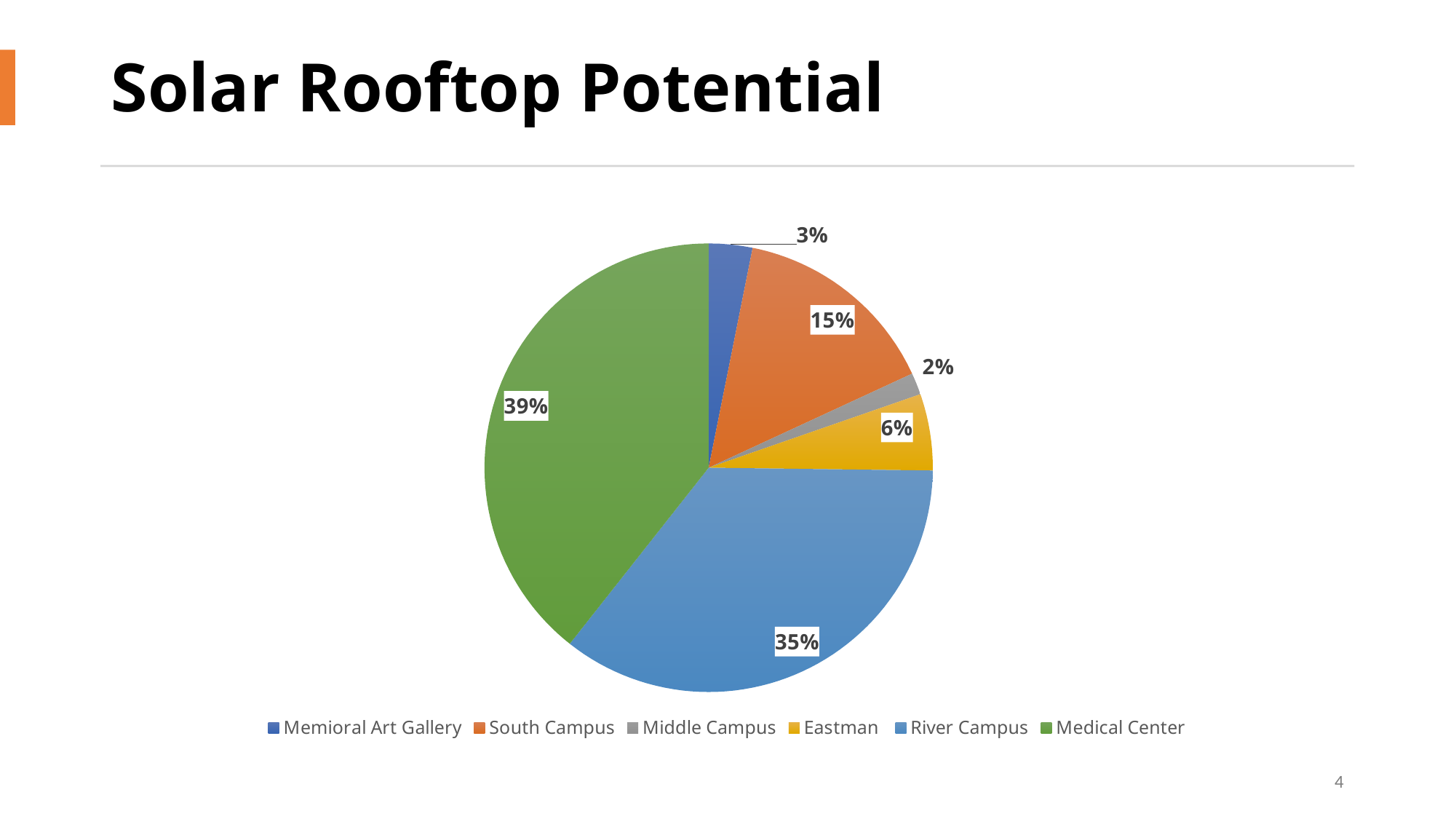
How many categories does the legend list? 6 What is the title of the slide? Solar Rooftop Potential What is the difference between the Medical Center and River Campus shares? 4% What share of the pie does Medical Center have? 39% Which is larger, South Campus or Eastman? South Campus What type of chart is shown on the slide? pie chart Which category has the smallest slice? Middle Campus What is the value for Eastman? 6% Which category has the largest slice? Medical Center What share of the pie does River Campus have? 35% What is the value for South Campus? 15% What is the value for Memioral Art Gallery? 3%